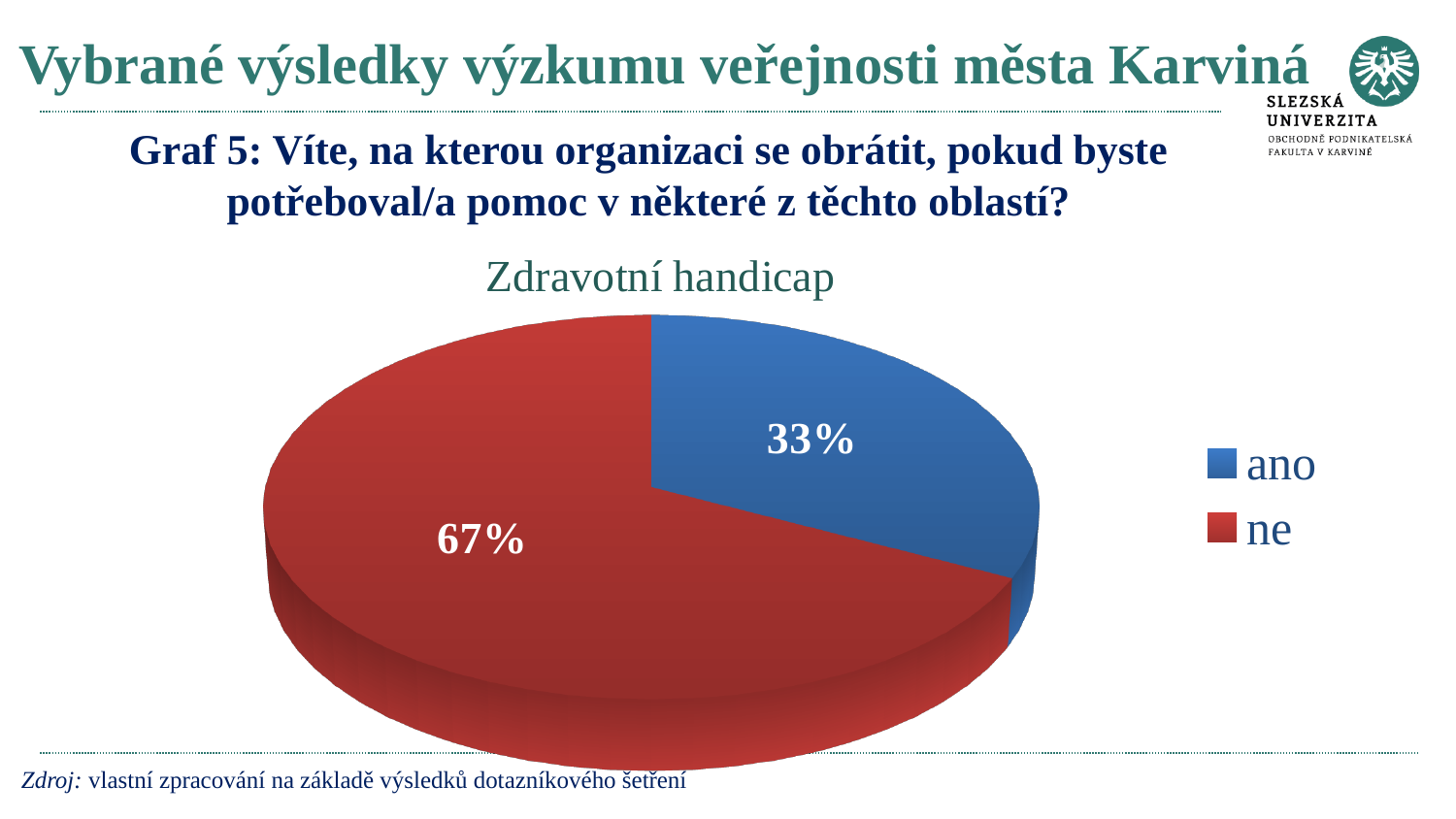
What percentage of the pie is labelled "ne"? 67% Which slice is the smallest? ano Which is larger, the "ano" slice or the "ne" slice? ne What colour is the "ne" slice? red Which slice is the largest? ne What percentage of the pie is labelled "ano"? 33% What kind of chart is shown on the slide? pie chart What is the title of the chart? Zdravotní handicap How many slices does the pie chart have? 2 How many entries does the legend list? 2 What is the difference in percentage points between the "ne" slice and the "ano" slice? 34 What share of the pie does the "ano" slice represent? 33%